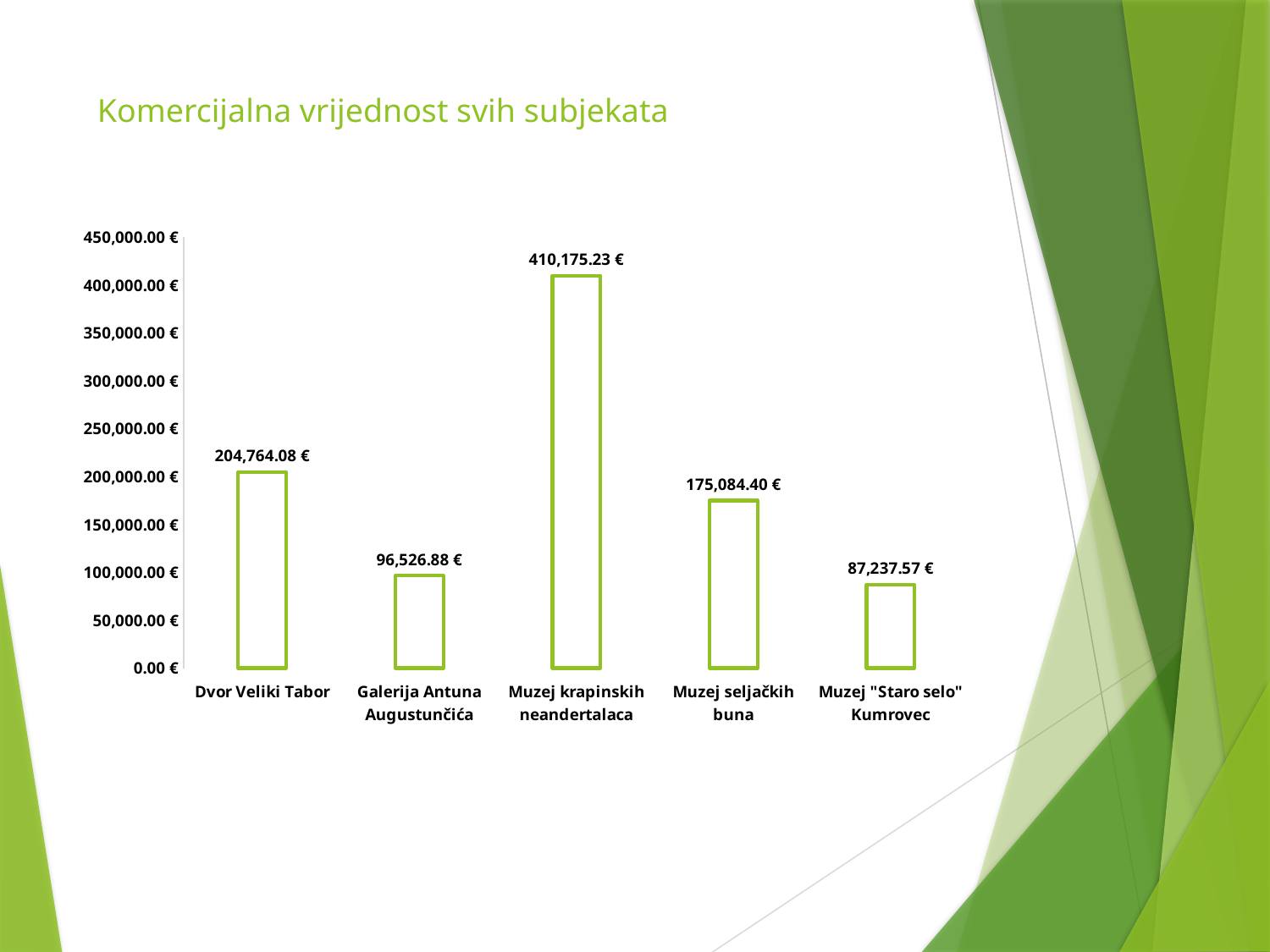
Which category has the highest value? Muzej krapinskih neandertalaca What is the value for Muzej "Staro selo" Kumrovec? 87,237.57 € Which category has the lowest value? Muzej "Staro selo" Kumrovec Which is larger, the value for Galerija Antuna Augustunčića or the value for Muzej seljačkih buna? Muzej seljačkih buna What is the value for Galerija Antuna Augustunčića? 96,526.88 € What is the difference between the values for Dvor Veliki Tabor and Muzej seljačkih buna? 29,679.68 € How many categories are shown in the chart? 5 What kind of chart is shown on the slide? bar chart What is the difference between the values for Muzej krapinskih neandertalaca and Dvor Veliki Tabor? 205,411.15 € Is the value for Muzej seljačkih buna greater or less than 150,000.00 €? greater What is the value for Dvor Veliki Tabor? 204,764.08 € What is the value for Muzej krapinskih neandertalaca? 410,175.23 €